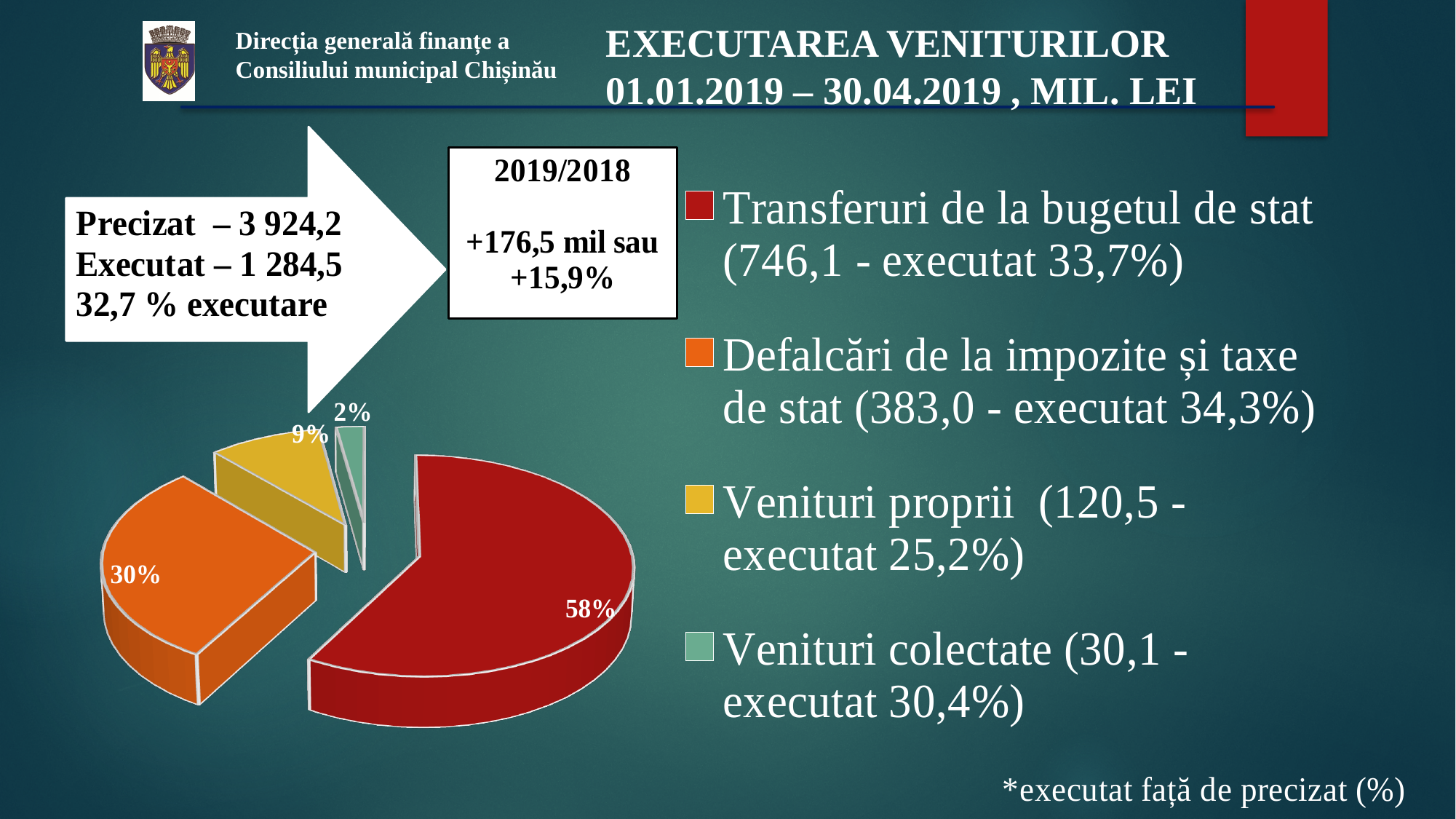
Which category has the largest slice of the pie? Transferuri de la bugetul de stat What share of the pie does the yellow slice (Venituri proprii) represent? 9% What share of the pie does the orange slice (Defalcări de la impozite și taxe de stat) represent? 30% Which slice is larger: Venituri proprii or Venituri colectate? Venituri proprii What share of the pie does the green slice (Venituri colectate) represent? 2% What colour is the slice for Defalcări de la impozite și taxe de stat? orange Which category has the smallest slice of the pie? Venituri colectate How many slices does the pie chart have? 4 How many categories are listed in the legend next to the pie chart? 4 What is the difference in percentage points between the red slice (58%) and the orange slice (30%)? 28 What kind of chart is shown on the slide? pie chart